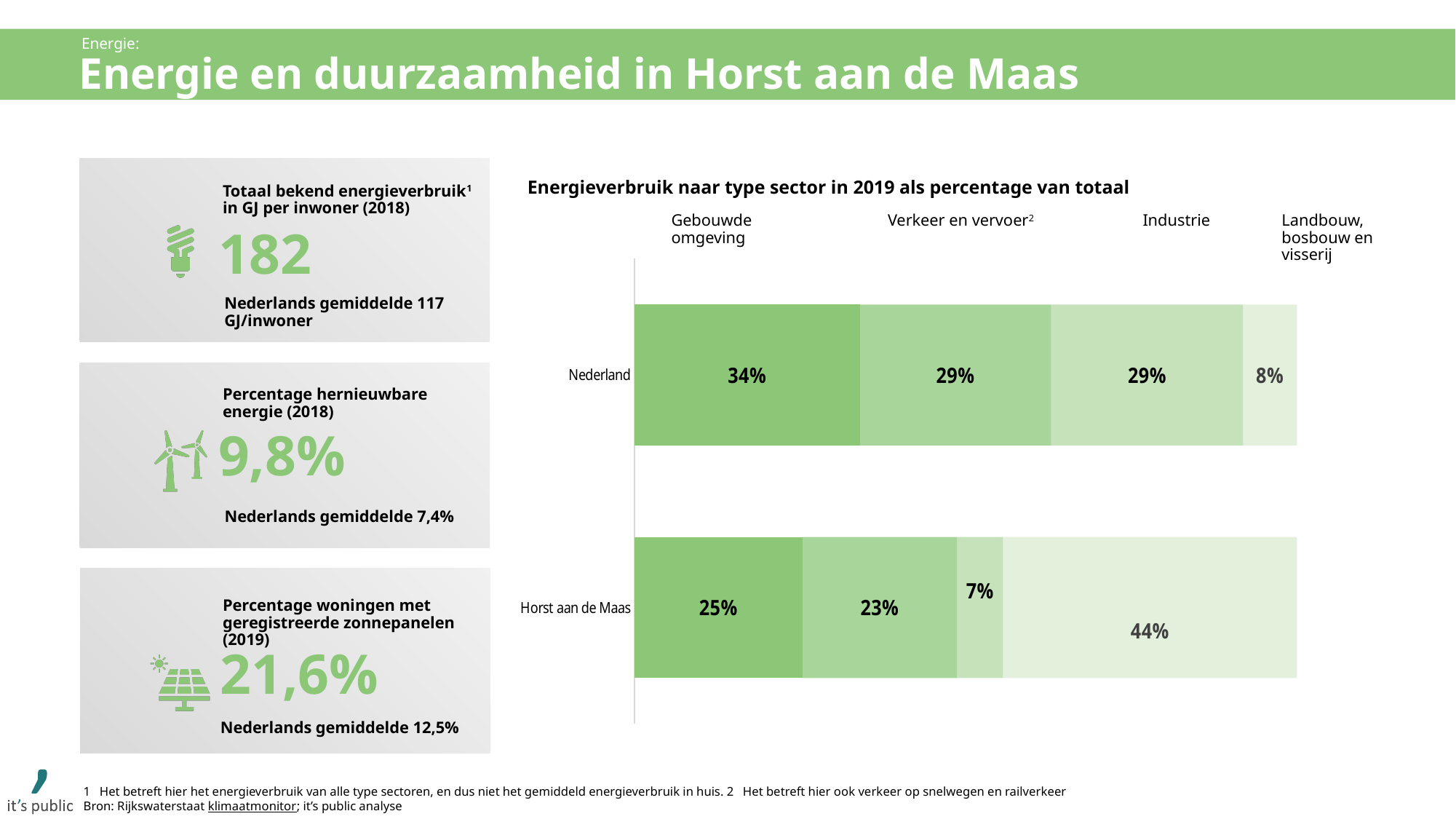
What is the total of the four sector shares for Nederland? 100% How many sectors are shown in the stacked bars? 4 What is the difference between the Landbouw, bosbouw en visserij share for Horst aan de Maas and for Nederland? 36 percentage points What is the value for Landbouw, bosbouw en visserij for Horst aan de Maas? 44% What is the value for Industrie for Horst aan de Maas? 7% What type of chart is shown under the title 'Energieverbruik naar type sector in 2019 als percentage van totaal'? Stacked bar chart Which has a larger Gebouwde omgeving share, Nederland or Horst aan de Maas? Nederland How many regions (bars) are shown in the chart? 2 Which sector has the largest share for Horst aan de Maas? Landbouw, bosbouw en visserij What is the value for Gebouwde omgeving for Nederland? 34% Which sector has the smallest share for Nederland? Landbouw, bosbouw en visserij What is the value for Verkeer en vervoer for Nederland? 29%